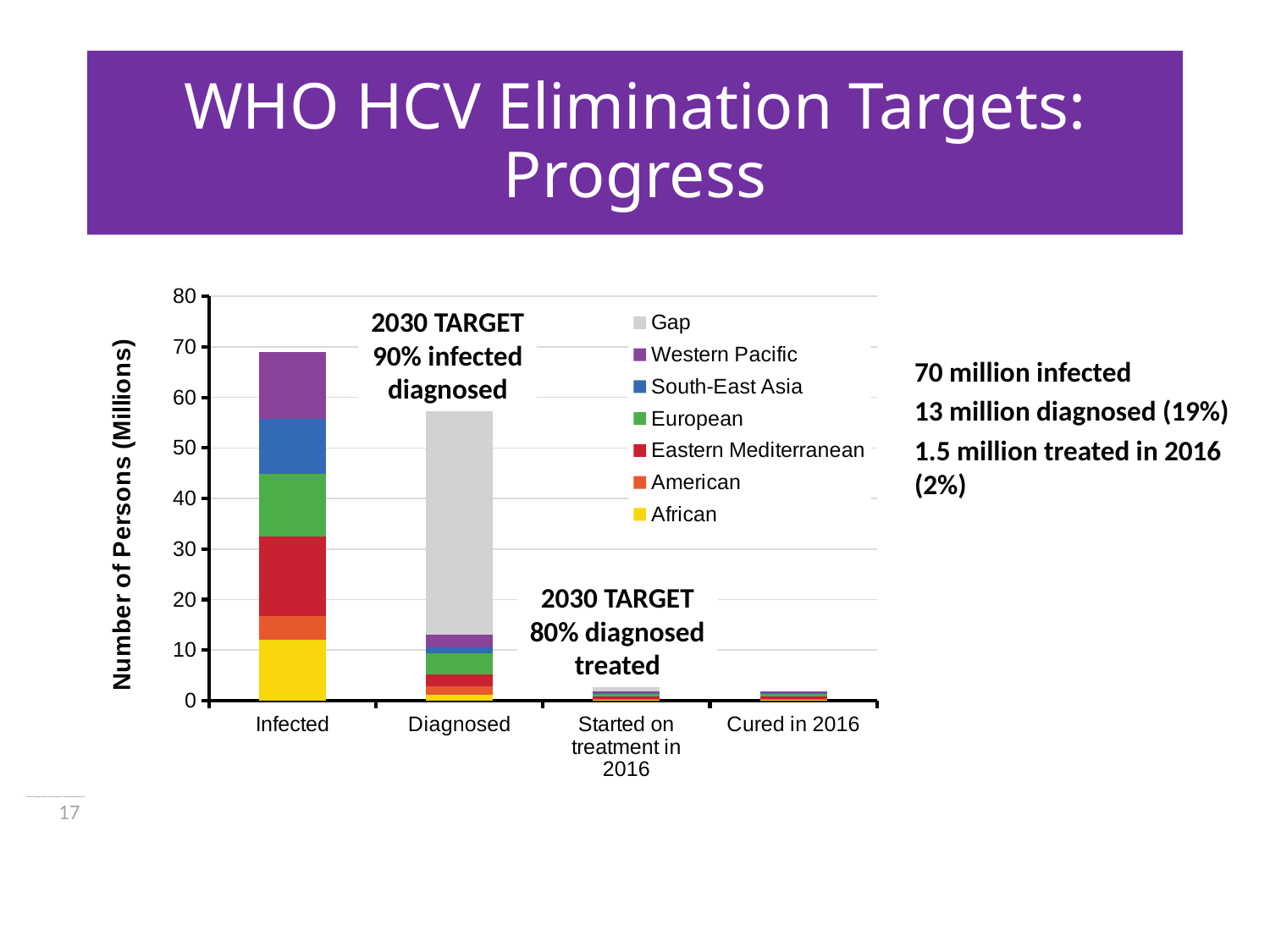
Is the total height of the Infected bar greater or less than 60? greater Is the value for Started on treatment in 2016 greater or less than 10? less Do the bar heights rise or fall moving from left to right along the x axis? Fall Which series in the legend is shown in yellow? African Is the total height of the Diagnosed bar (including the Gap segment) greater or less than 50? greater How many series does the chart's legend list? 7 Which category has the tallest bar in the chart? Infected What is the title of the chart's y axis? Number of Persons (Millions) What kind of chart is shown on the slide? Stacked bar chart Which category has the shortest bar in the chart? Cured in 2016 Which bar is taller, Infected or Diagnosed? Infected How many categories are shown on the x axis of the chart? 4